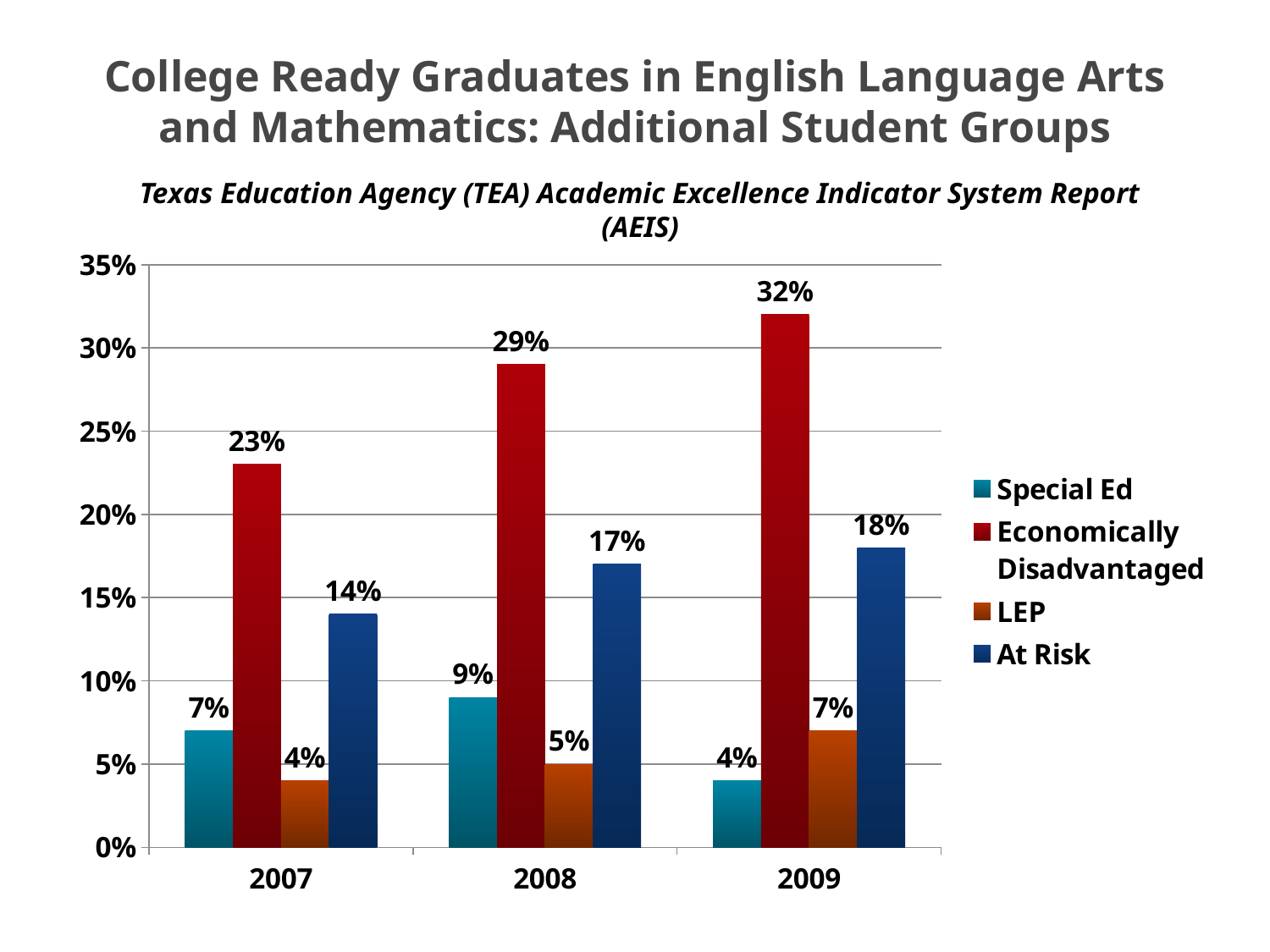
Which is larger in 2007: the At Risk value or the Special Ed value? At Risk What is the difference between the Economically Disadvantaged values in 2009 and 2007? 9% What is the value for LEP in 2007? 4% In which year is the Economically Disadvantaged value highest? 2009 What is the value for Special Ed in 2008? 9% What kind of chart is shown on the slide? Bar chart Does the At Risk value rise or fall from 2007 to 2009? Rise How many series does the legend list? 4 How many years are shown on the x axis? 3 What is the value for At Risk in 2008? 17% Which student group has the lowest value in 2009? Special Ed What is the value for Economically Disadvantaged in 2009? 32%